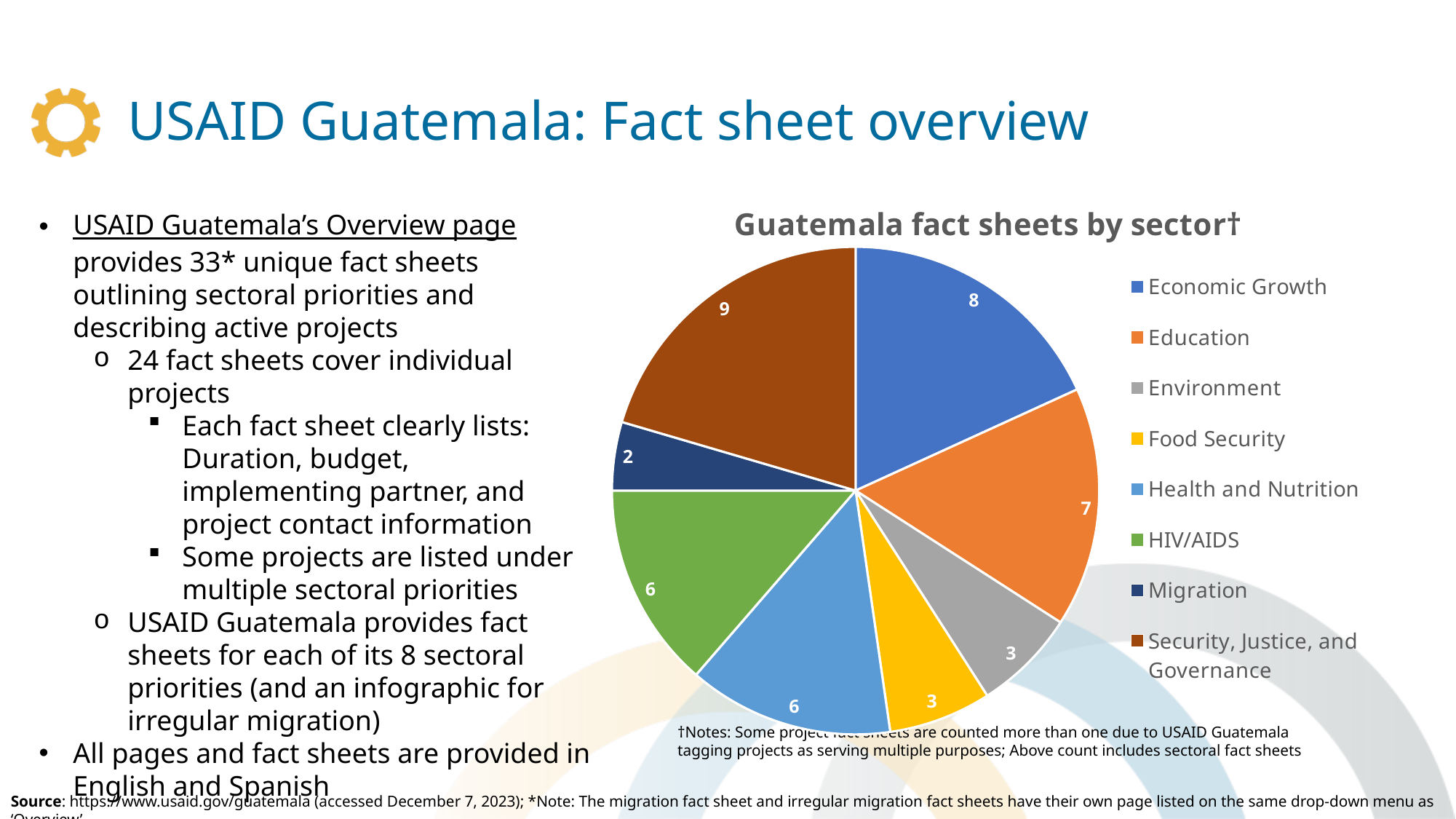
How many fact sheets does the pie chart show for Education? 7 What is the total number of fact sheets across all slices of the pie chart? 44 What is the difference between the number of fact sheets for Security, Justice, and Governance and for Migration? 7 Which sector has the smallest slice in the pie chart? Migration How many fact sheets does the pie chart show for Migration? 2 What is the title of the chart? Guatemala fact sheets by sector Which sector has more fact sheets, Education or Health and Nutrition? Education What share of the pie chart does Security, Justice, and Governance represent, rounded to the nearest whole percent? 20% What kind of chart is shown on the slide? pie chart How many fact sheets does the pie chart show for Economic Growth? 8 How many sectors does the legend of the pie chart list? 8 Which sector has the largest slice in the pie chart? Security, Justice, and Governance